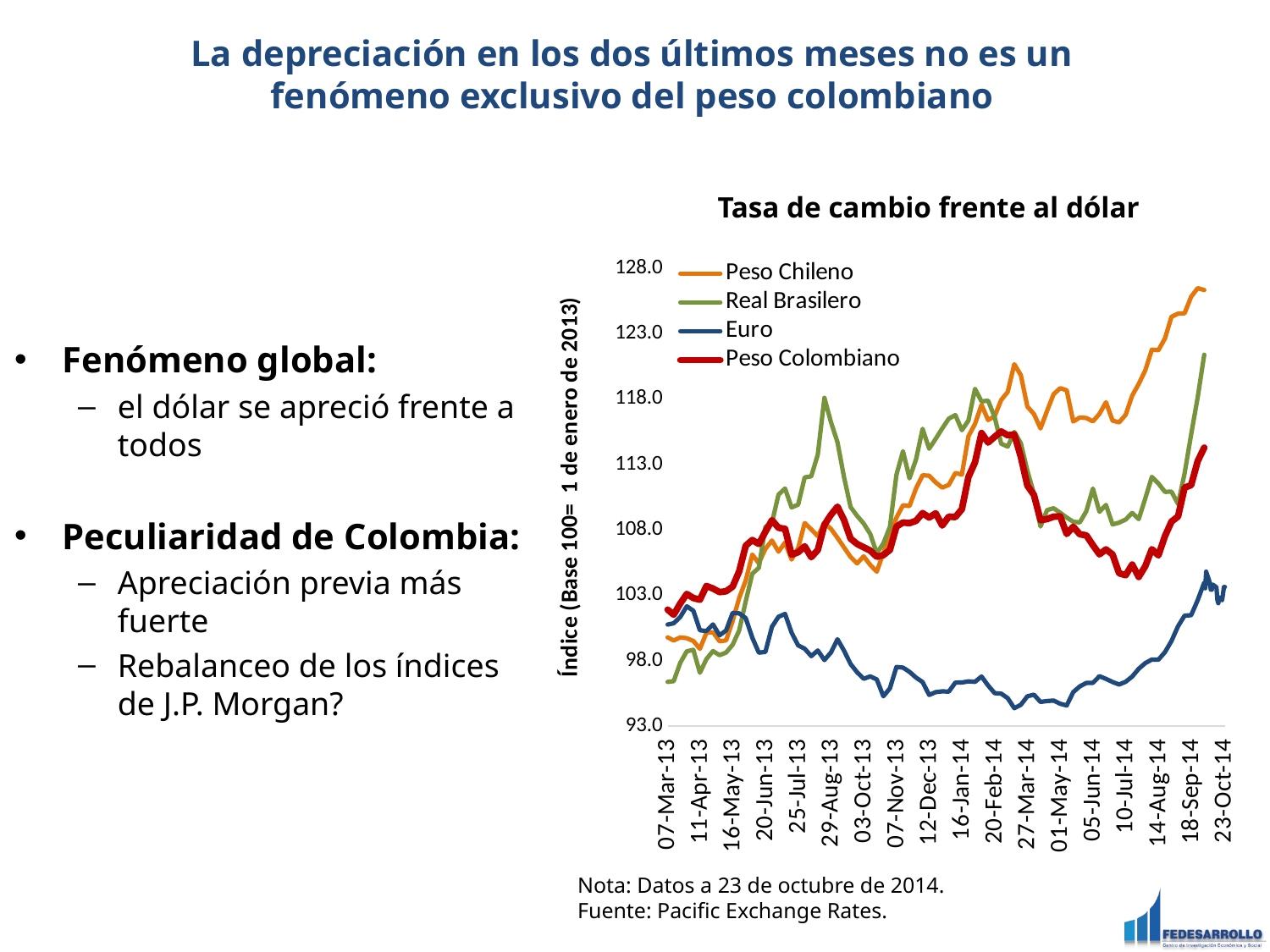
How many series does the legend of the chart list? 4 Is the value of the Euro around 01-May-14 greater or less than 98.0? less Which series has the lowest value at the end of the chart (23-Oct-14)? Euro Which series reaches the highest value on the chart? Peso Chileno Is the value of the Peso Chileno at 23-Oct-14 greater or less than 123.0? greater At 23-Oct-14, which is higher: the Peso Chileno or the Euro? Peso Chileno What is the title of the chart? Tasa de cambio frente al dólar What kind of chart is shown on the slide? line chart Which colour is used for the Peso Colombiano line? red Is the value of the Peso Colombiano around 10-Jul-14 greater or less than 108.0? less Does the Peso Chileno line rise or fall between 10-Jul-14 and 23-Oct-14? rise